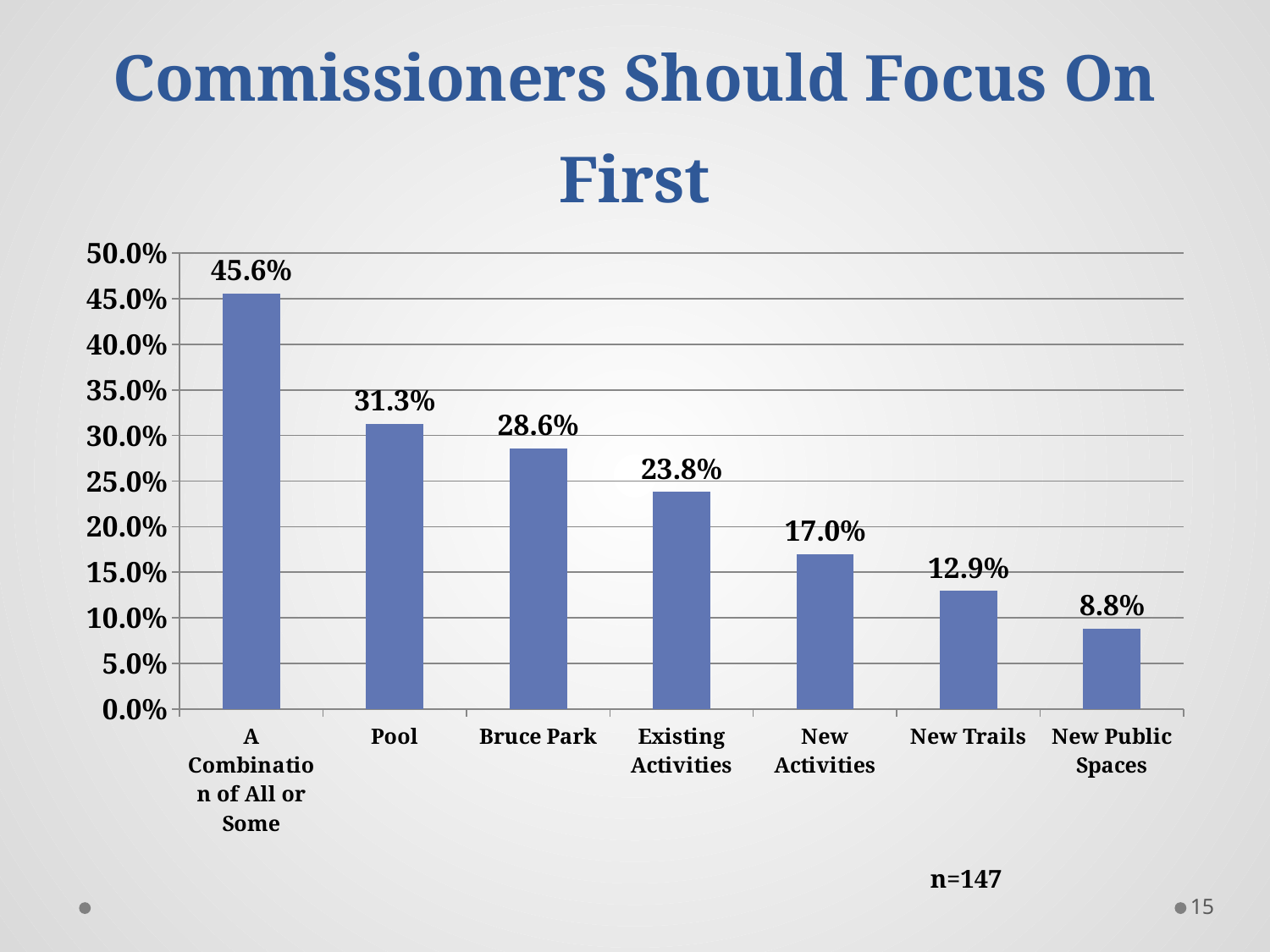
Which category has the lowest value? New Public Spaces How many categories are shown on the chart? 7 Is the value for New Activities greater or less than 20.0%? less What is the difference between the values for New Activities and New Public Spaces? 8.2% What is the value for Existing Activities? 23.8% Do the values rise or fall from left to right along the x axis? fall What is the value for New Trails? 12.9% What is the difference between the values for Pool and Bruce Park? 2.7% What is the value for Pool? 31.3% What kind of chart is shown on the slide? bar chart Which category has the highest value? A Combination of All or Some Which is larger, the value for Bruce Park or the value for Existing Activities? Bruce Park